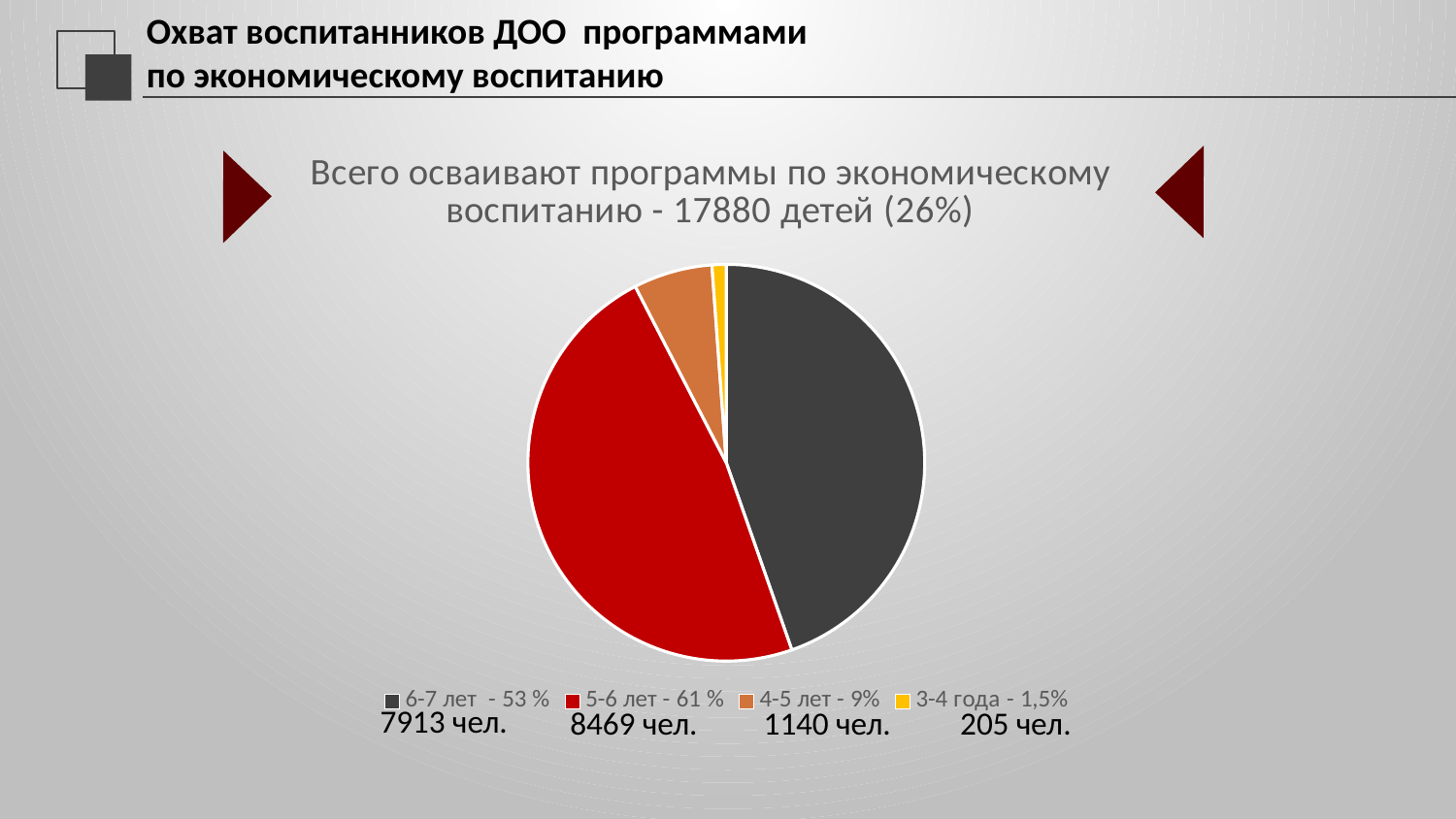
What colour is the slice for the 5-6 лет category? red How many entries does the legend of the pie chart list? 4 How many children (чел.) are in the 5-6 лет category? 8469 чел. How many children (чел.) are in the 4-5 лет category? 1140 чел. How many children (чел.) are in the 3-4 года category? 205 чел. What is the difference in the number of children between the 5-6 лет and 6-7 лет categories? 556 Which age category has the smallest number of children? 3-4 года How many children (чел.) are in the 6-7 лет category? 7913 чел. How many categories (slices) does the pie chart have? 4 Which category has more children: 4-5 лет or 3-4 года? 4-5 лет Which age category has the largest number of children? 5-6 лет What kind of chart is shown on the slide? pie chart